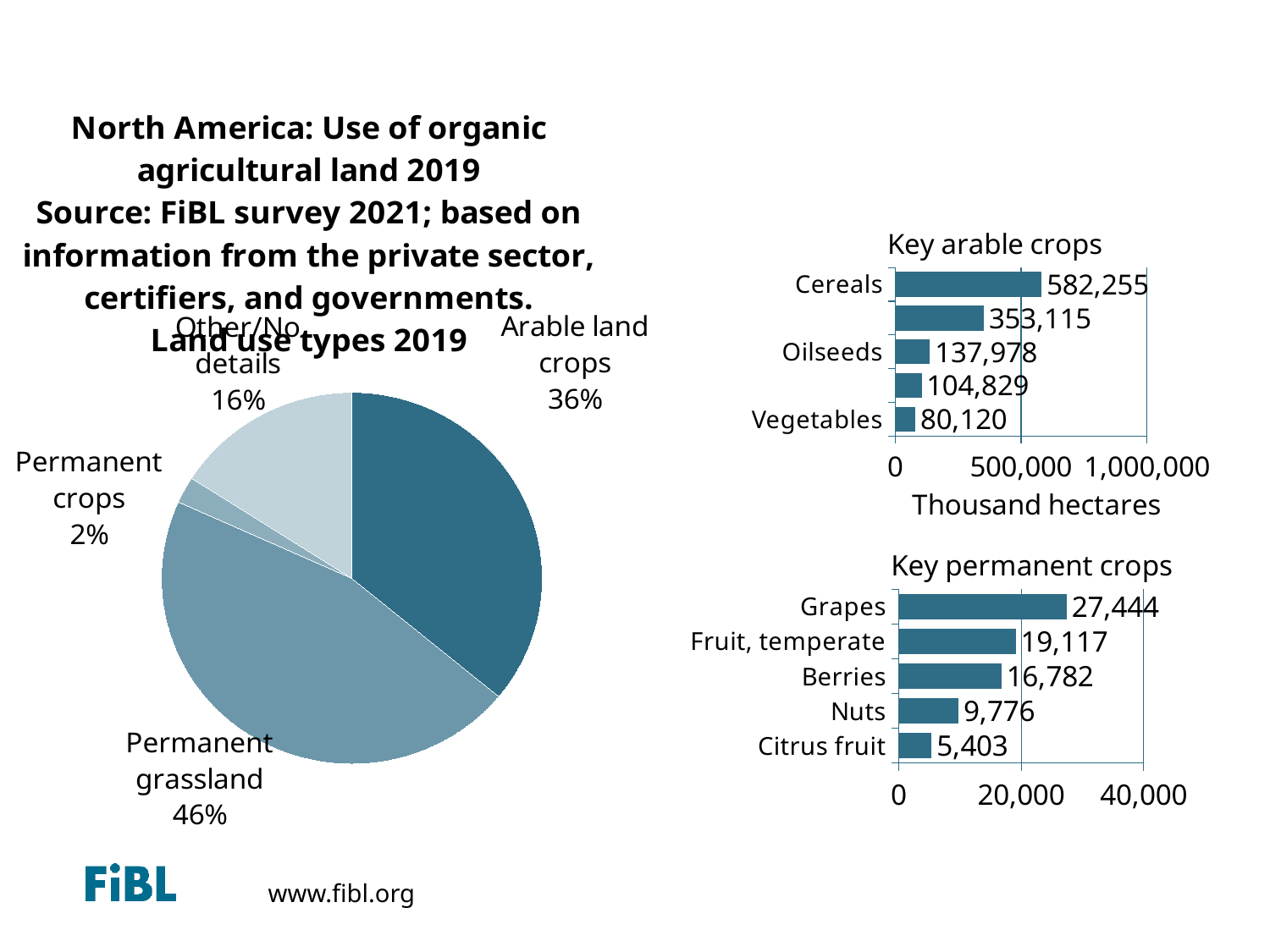
In the 'Key permanent crops' chart, what is the value for Nuts? 9,776 In the 'Key permanent crops' chart, which is larger, Berries or Citrus fruit? Berries In the 'Key arable crops' chart, what is the difference between Cereals and Oilseeds? 444,277 In the 'Land use types 2019' pie chart, which category has the smallest share? Permanent crops In the 'Land use types 2019' pie chart, how many slices are there? 4 In the 'Land use types 2019' pie chart, what share is Arable land crops? 36% In the 'Land use types 2019' pie chart, what share is Permanent grassland? 46% In the 'Key permanent crops' chart, how many categories are shown? 5 In the 'Key arable crops' chart, what kind of chart is shown? Bar chart In the 'Key permanent crops' chart, which category has the highest value? Grapes In the 'Key arable crops' chart, what is the value for Cereals? 582,255 In the 'Key arable crops' chart, what is the value for Vegetables? 80,120